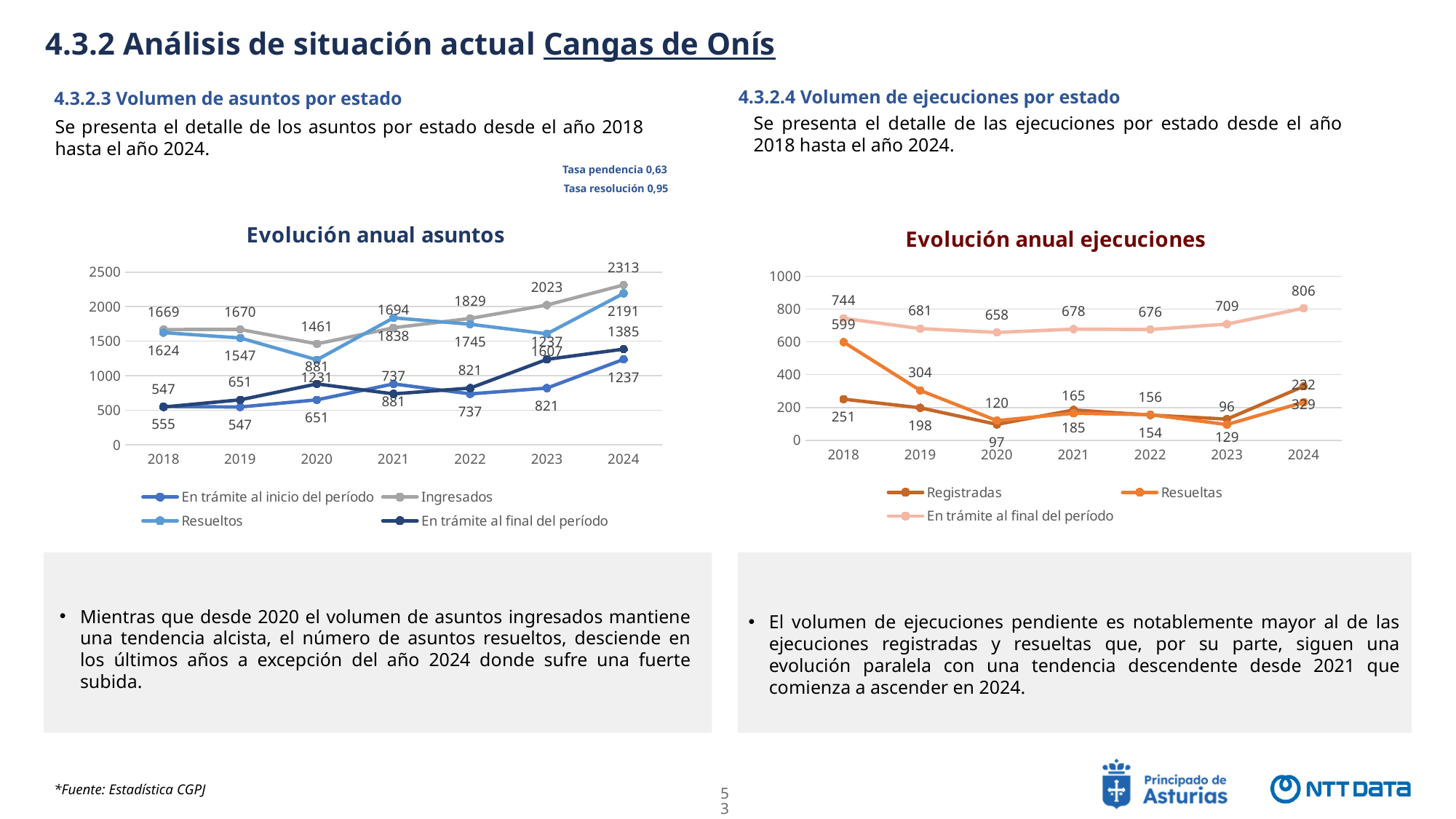
In the 'Evolución anual asuntos' chart, how many series does the legend list? 4 In the 'Evolución anual ejecuciones' chart, in which year is 'En trámite al final del período' highest? 2024 In the 'Evolución anual asuntos' chart, in which year is Ingresados lowest? 2020 In the 'Evolución anual ejecuciones' chart, what is the value of 'En trámite al final del período' in 2024? 806 What kind of chart is 'Evolución anual asuntos'? line chart In the 'Evolución anual asuntos' chart, what is the value of Ingresados in 2024? 2313 In the 'Evolución anual ejecuciones' chart, how many years are shown on the x axis? 7 In the 'Evolución anual asuntos' chart, do the Ingresados values rise or fall from 2020 to 2024? rise In the 'Evolución anual asuntos' chart, what is the value of Ingresados in 2020? 1461 In the 'Evolución anual ejecuciones' chart, which is larger in 2018, Registradas or Resueltas? Resueltas In the 'Evolución anual asuntos' chart, what is the difference between Ingresados in 2024 and in 2023? 290 In the 'Evolución anual ejecuciones' chart, what is the value of Resueltas in 2018? 599